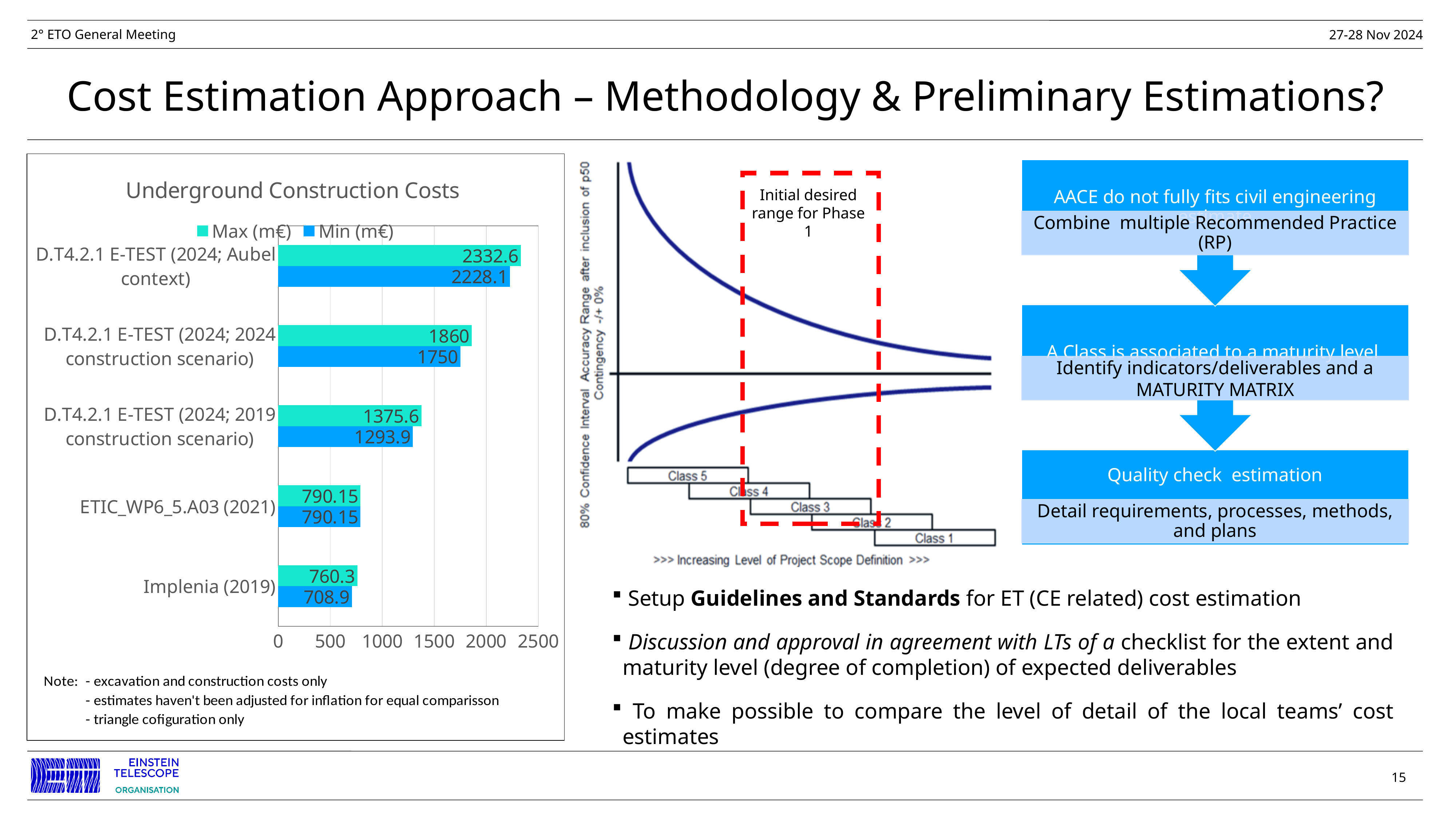
In the Underground Construction Costs chart, what is the Max (m€) value for D.T4.2.1 E-TEST (2024; Aubel context)? 2332.6 In the Underground Construction Costs chart, what is the Min (m€) value for Implenia (2019)? 708.9 In the Underground Construction Costs chart, what is the difference between the Max and Min values for D.T4.2.1 E-TEST (2024; Aubel context)? 104.5 In the Underground Construction Costs chart, what is the Max (m€) value for ETIC_WP6_5.A03 (2021)? 790.15 In the Underground Construction Costs chart, is the Max (m€) value for D.T4.2.1 E-TEST (2024; 2019 construction scenario) larger than the Max (m€) value for ETIC_WP6_5.A03 (2021)? Yes How many categories are shown in the Underground Construction Costs chart? 5 In the Underground Construction Costs chart, what is the Min (m€) value for D.T4.2.1 E-TEST (2024; 2024 construction scenario)? 1750 In the Underground Construction Costs chart, which category has the lowest Min (m€) value? Implenia (2019) How many series does the legend of the Underground Construction Costs chart list? 2 In the Underground Construction Costs chart, which category has the highest Max (m€) value? D.T4.2.1 E-TEST (2024; Aubel context) What kind of chart is the Underground Construction Costs chart? Bar chart In the Underground Construction Costs chart, what is the difference between the Max and Min values for D.T4.2.1 E-TEST (2024; 2024 construction scenario)? 110